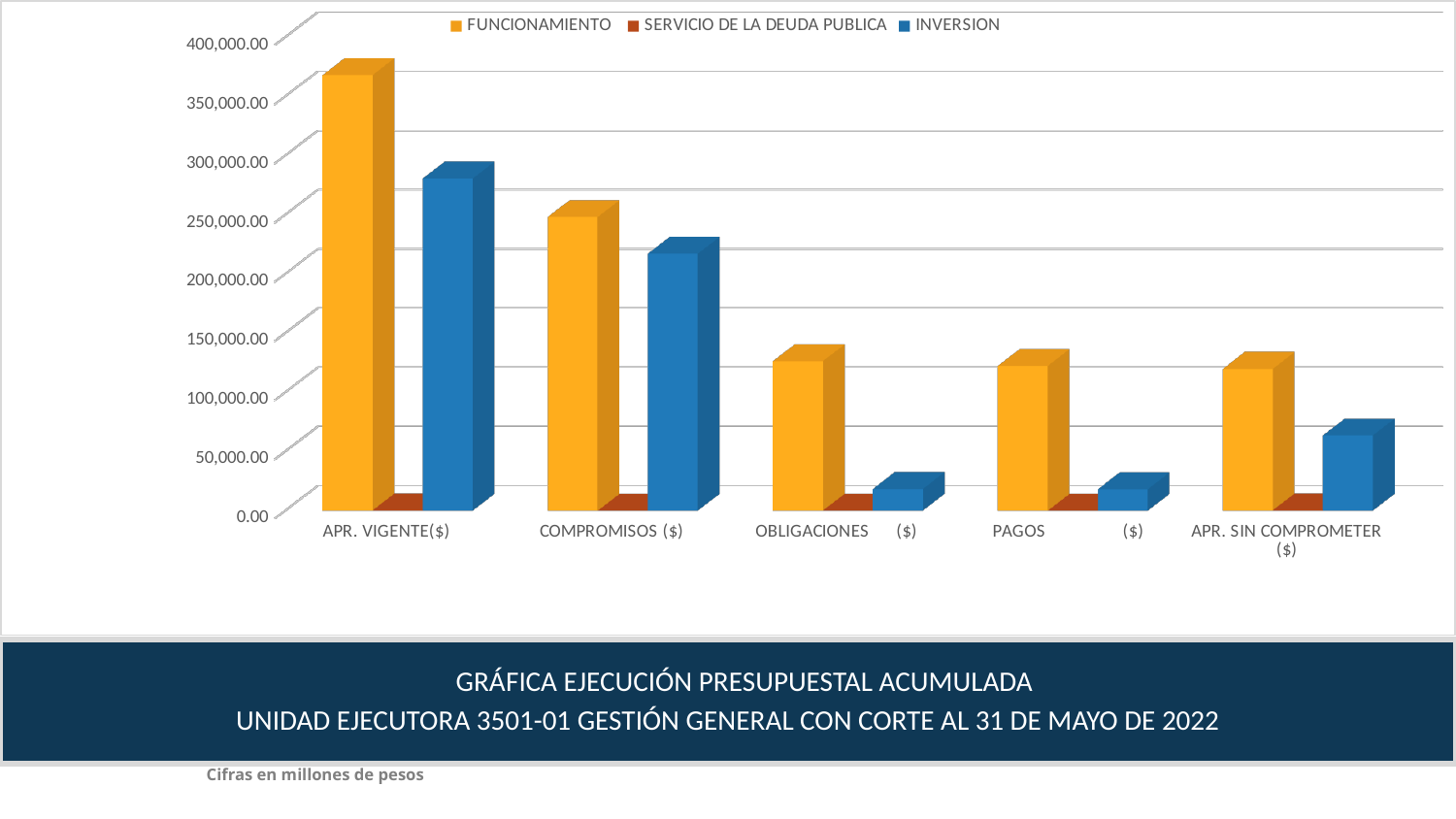
Is the INVERSION value for OBLIGACIONES ($) greater or less than 50,000.00? less What kind of chart is shown on the slide? bar chart Which series is shown in blue in the legend? INVERSION How many categories are shown on the x axis? 5 For APR. VIGENTE($), which is larger, FUNCIONAMIENTO or INVERSION? FUNCIONAMIENTO Is the INVERSION value for APR. VIGENTE($) greater or less than 300,000.00? less What is the title shown below the chart? GRÁFICA EJECUCIÓN PRESUPUESTAL ACUMULADA UNIDAD EJECUTORA 3501-01 GESTIÓN GENERAL CON CORTE AL 31 DE MAYO DE 2022 Do the FUNCIONAMIENTO bars rise or fall from APR. VIGENTE($) to APR. SIN COMPROMETER ($)? fall For which category is the FUNCIONAMIENTO bar highest? APR. VIGENTE($) Which series has the lowest bars across all categories? SERVICIO DE LA DEUDA PUBLICA Is the FUNCIONAMIENTO value for APR. VIGENTE($) greater or less than 300,000.00? greater How many series does the legend list? 3